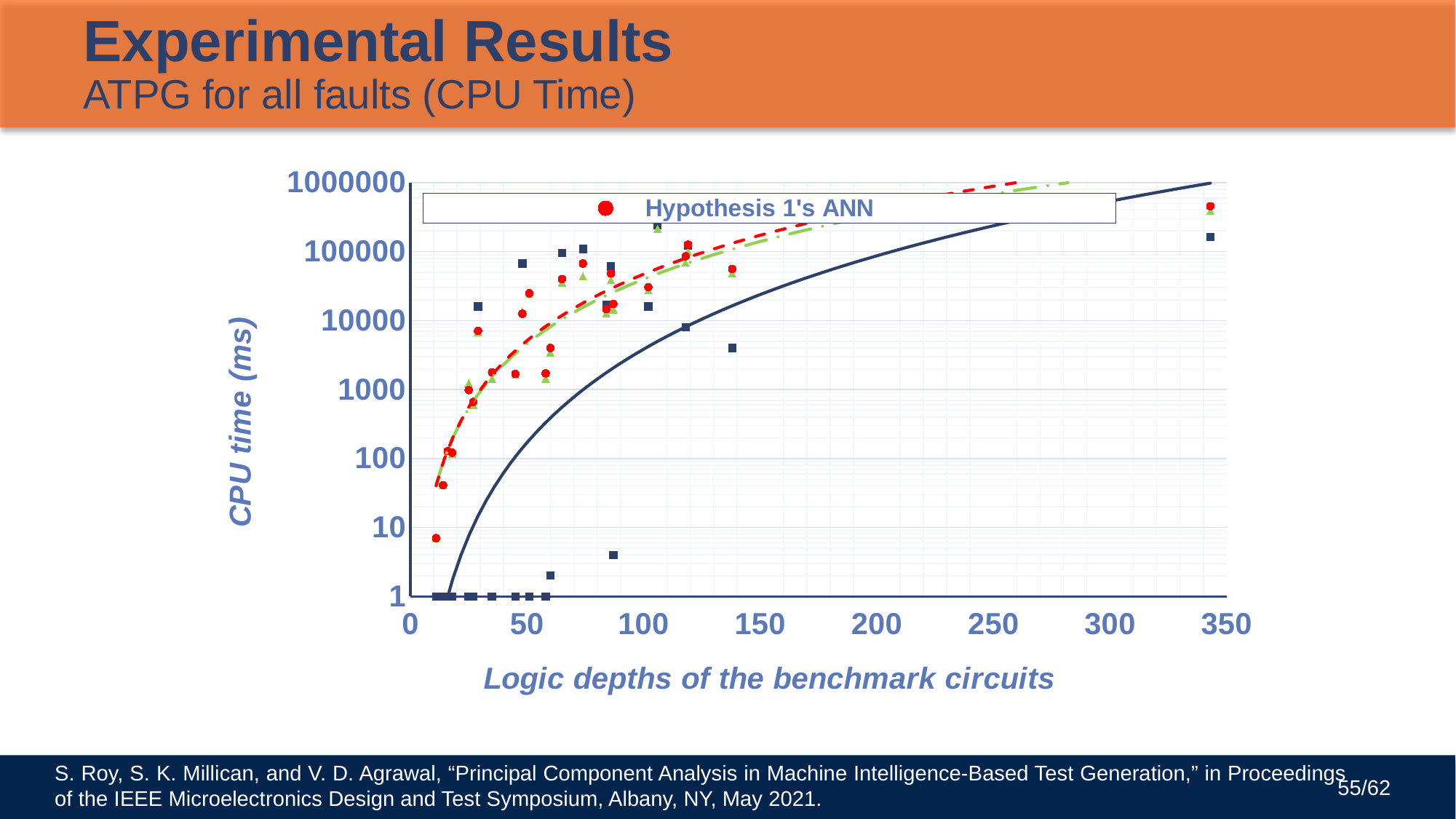
How many tick labels are shown on the x axis? 8 How many series does the chart's legend list? 1 What kind of chart is shown on the slide? scatter chart What series name appears in the chart's legend? Hypothesis 1's ANN What is the highest tick value shown on the x axis? 350 What is the title of the y axis? CPU time (ms) Is the Hypothesis 1's ANN value at the smallest logic depth (near 10) greater or less than 10? less How many tick labels are shown on the y axis? 7 Is the Hypothesis 1's ANN value at the largest logic depth (near 340) greater or less than 100000? greater Is the Hypothesis 1's ANN value at a logic depth of about 120 greater or less than 10000? greater Do the Hypothesis 1's ANN values generally rise or fall as logic depth increases? rise What is the highest tick value shown on the y axis? 1000000